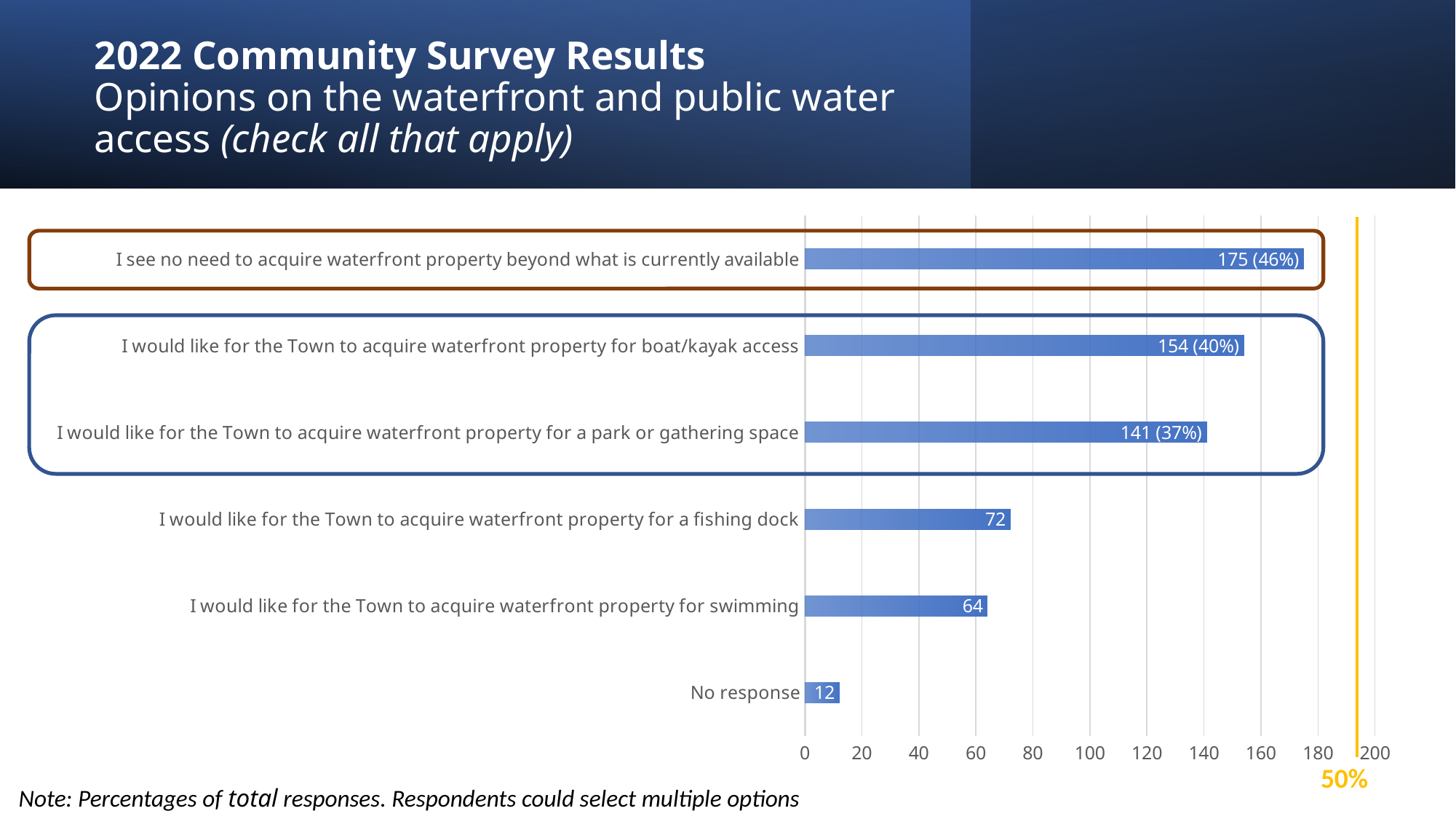
Which is larger: the value for 'a fishing dock' or the value for 'swimming'? a fishing dock What is the value for 'No response'? 12 Which category has the lowest value? No response Which category has the highest value? I see no need to acquire waterfront property beyond what is currently available Is the value for 'a park or gathering space' greater or less than 120? greater What is the value for 'I would like for the Town to acquire waterfront property for boat/kayak access'? 154 (40%) What is the difference in count between 'boat/kayak access' and 'a park or gathering space'? 13 What percentage is marked by the yellow vertical line on the chart? 50% What is the value for 'I would like for the Town to acquire waterfront property for a fishing dock'? 72 What kind of chart is shown on the slide? bar chart What is the value for 'I see no need to acquire waterfront property beyond what is currently available'? 175 (46%) How many categories are shown in the chart? 6